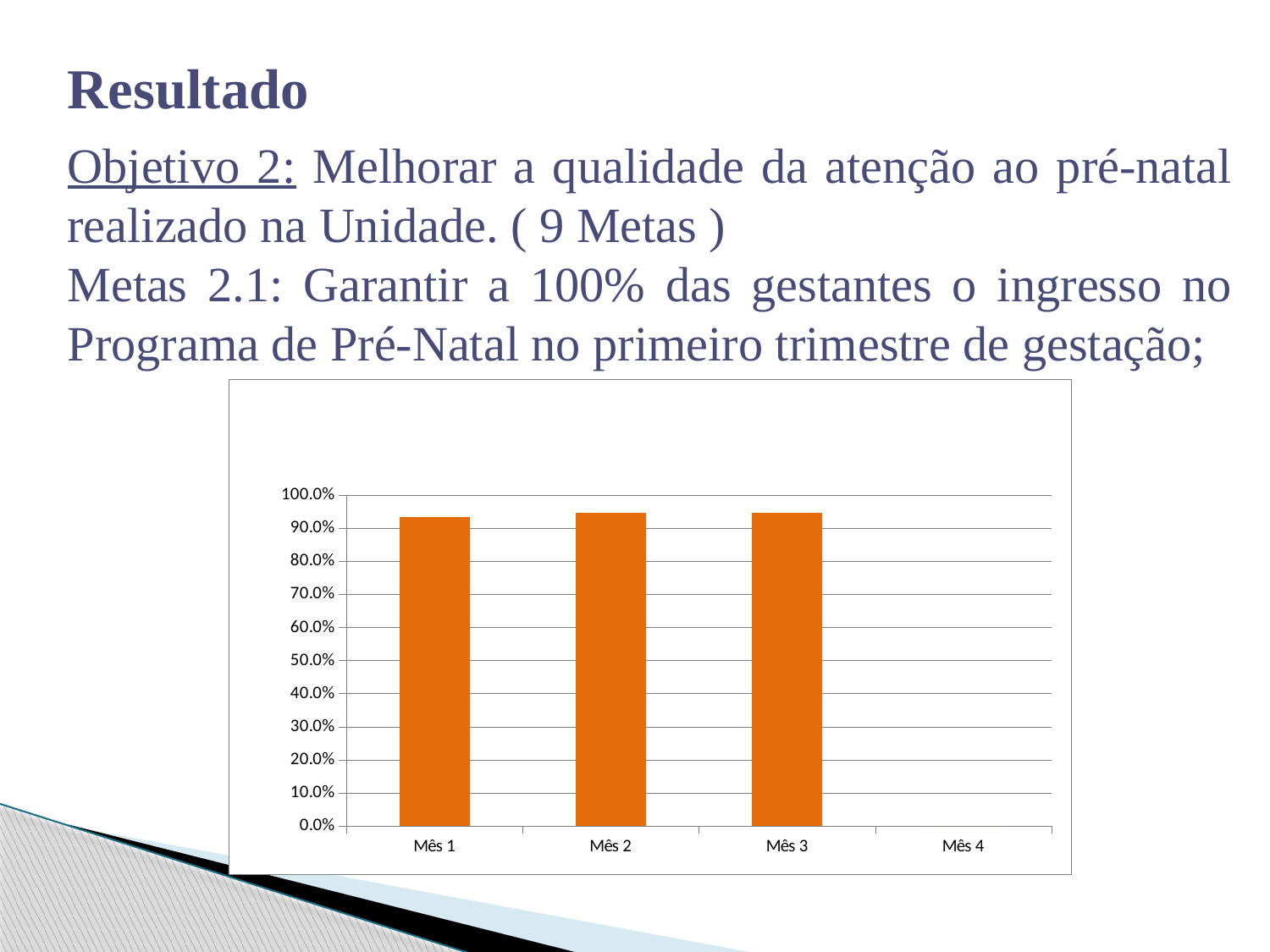
How many categories are shown on the x axis of the chart? 4 What is the highest value shown on the y axis of the chart? 100.0% What colour are the bars in the chart? orange Is the value for Mês 1 greater or less than 100.0%? less Is the value for Mês 1 greater or less than 90.0%? greater Is the value for Mês 2 greater or less than 100.0%? less Which category on the x axis has no bar plotted? Mês 4 What kind of chart is shown on the slide? bar chart